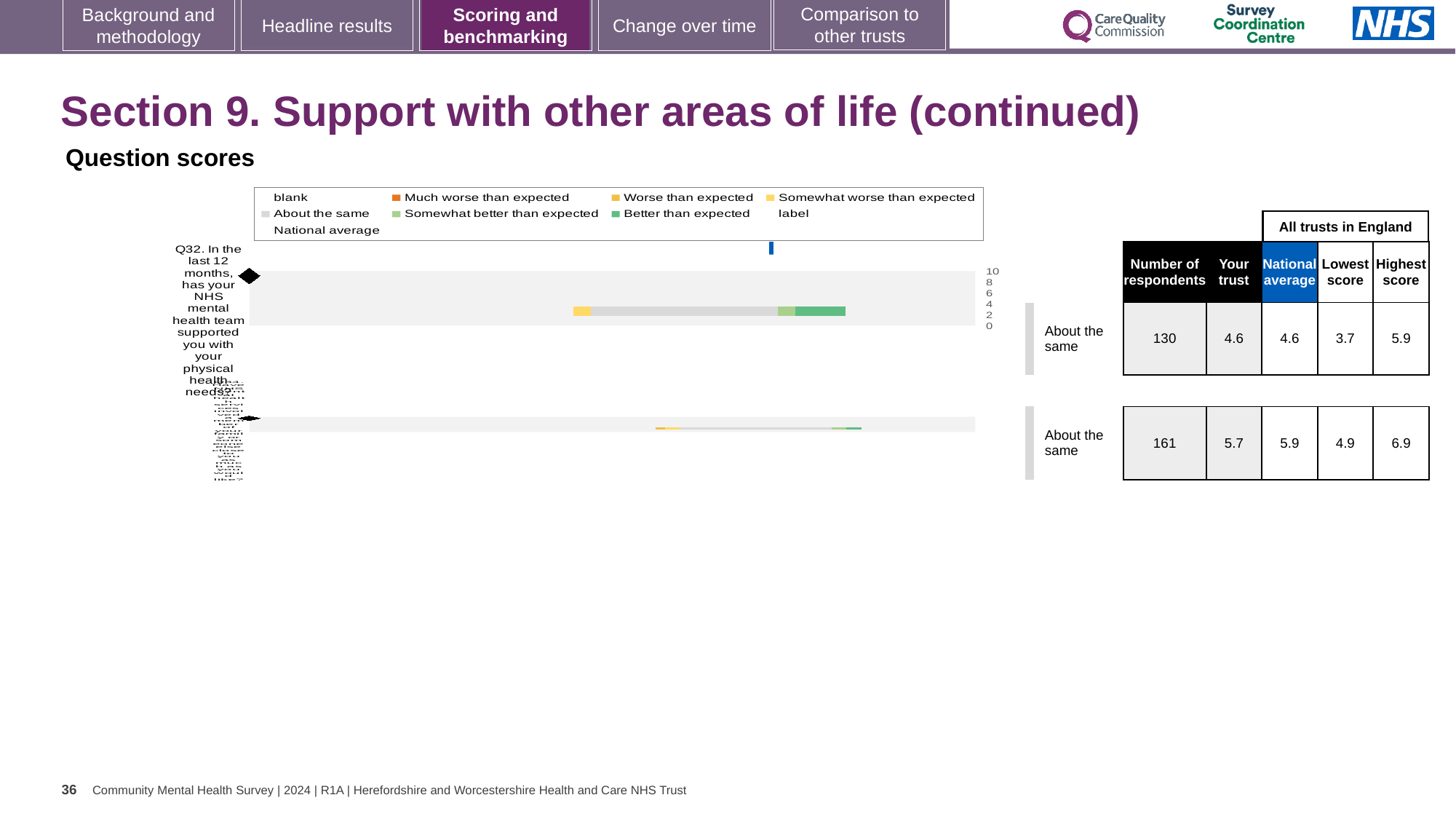
What is the highest value shown on the score axis of the question scores chart? 10 In the second row of the question scores table, which is larger: the 'Your trust' score or the national average? National average What is the lowest score among all trusts in England for Q32? 3.7 Which legend entry is shown in orange in the question scores chart? Much worse than expected What is the highest score among all trusts in England for Q32? 5.9 What is the national average score for Q32? 4.6 How many respondents answered Q32? 130 How many question bars are plotted in the question scores chart? 2 What benchmark category is shown next to the Q32 bar? About the same What is the difference between the highest and lowest trust scores for Q32? 2.2 What kind of chart is used to show the question scores on this slide? bar chart What is the 'Your trust' score for Q32 in the question scores table? 4.6